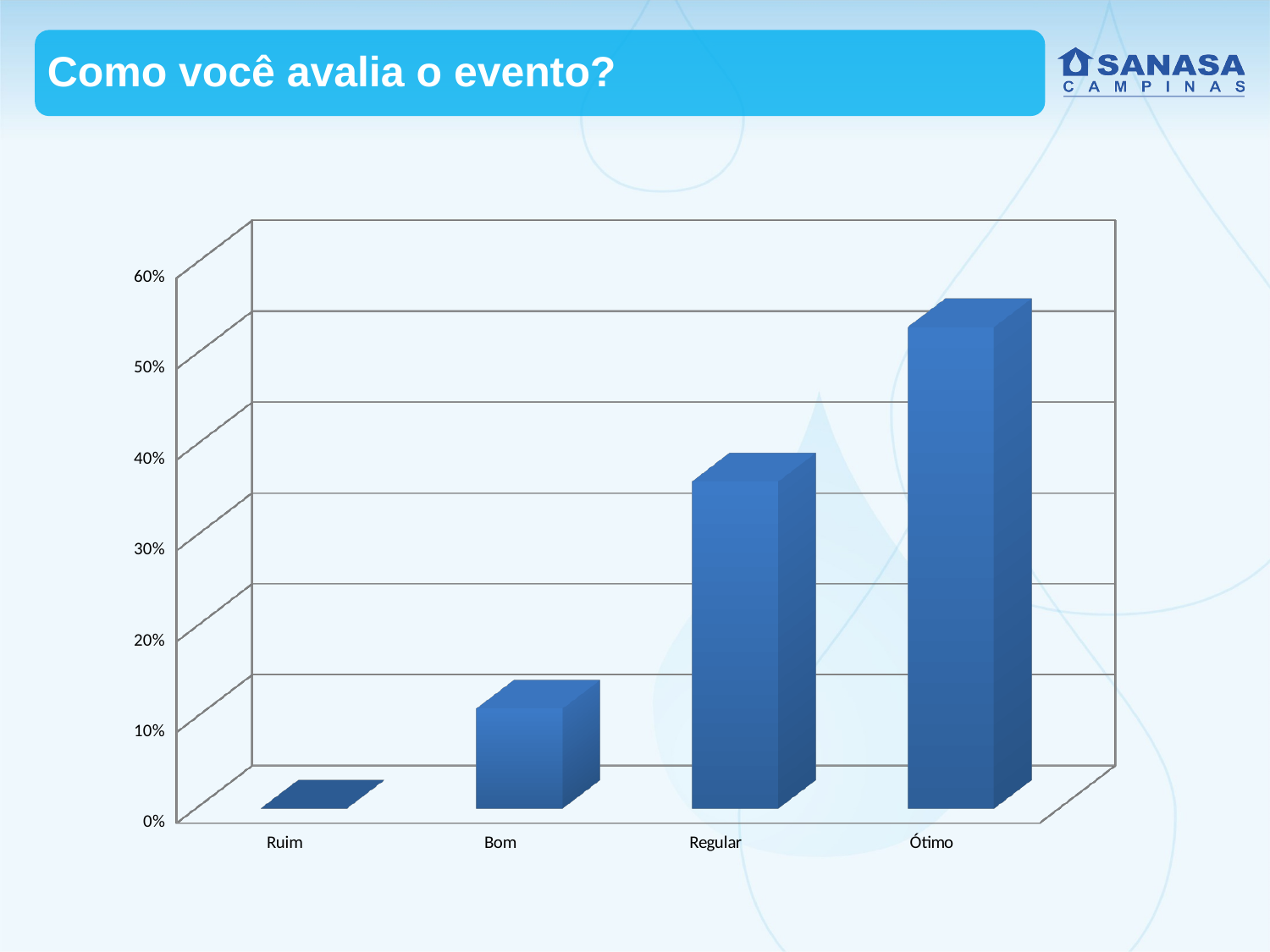
Is the value for Ruim greater or less than 10%? less Is the value for Regular greater or less than 30%? greater What is the title of the slide containing the chart? Como você avalia o evento? Do the bar values rise or fall from left to right across the categories? rise Which is larger, the value for Ótimo or the value for Regular? Ótimo Is the value for Bom greater or less than 20%? less Which category has the highest bar in the chart? Ótimo What kind of chart is shown on the slide? bar chart Which category has the lowest bar in the chart? Ruim Which is larger, the value for Regular or the value for Bom? Regular How many categories are shown on the x axis of the chart? 4